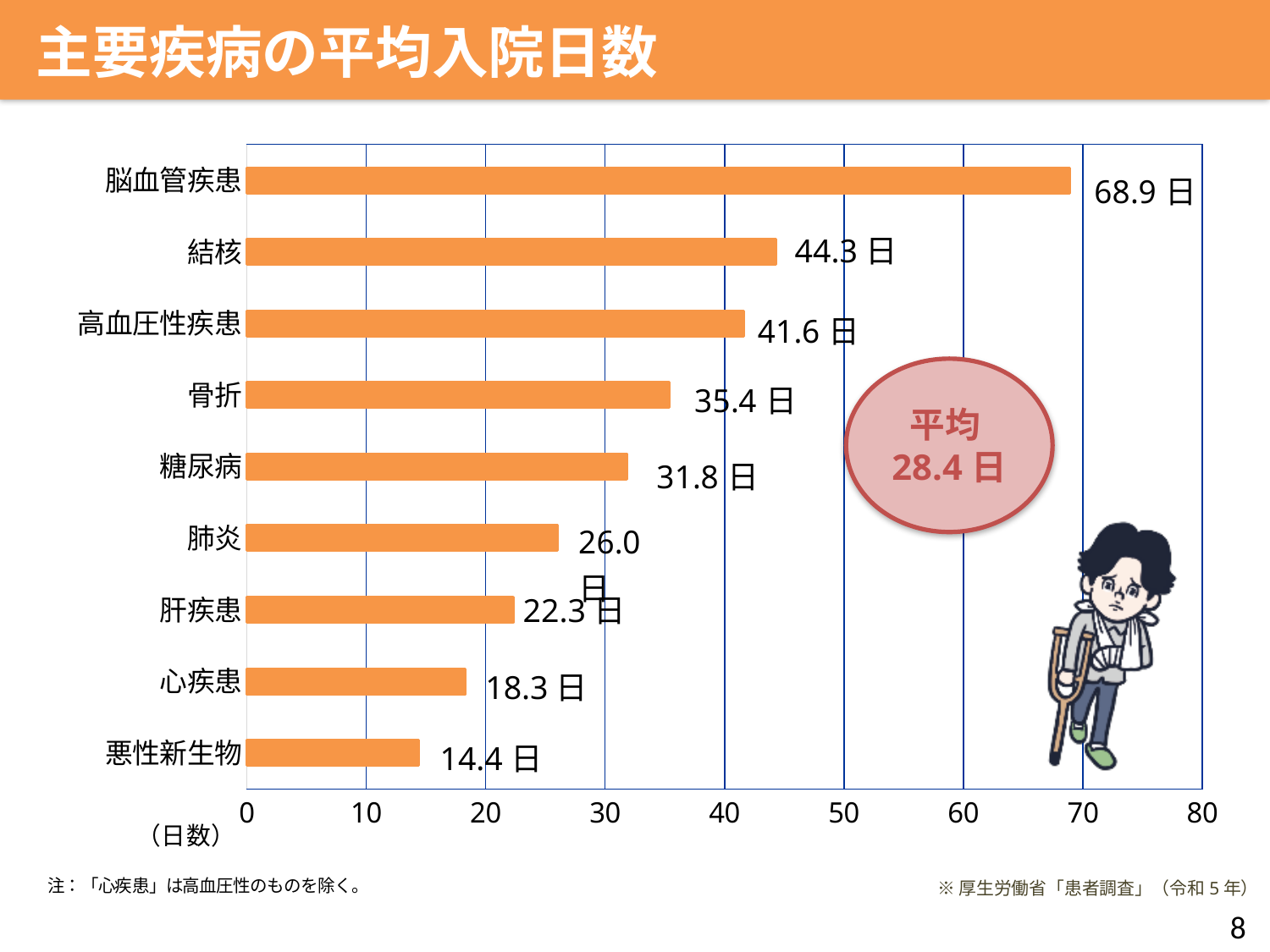
Is the value for 心疾患 greater or less than 20? less Which disease has the shortest average hospital stay? 悪性新生物 What is the average hospital stay for 脳血管疾患? 68.9 日 Which has a longer average hospital stay, 骨折 or 肺炎? 骨折 What kind of chart is shown on the slide? bar chart What is the average hospital stay for 悪性新生物? 14.4 日 How many diseases are shown in the chart? 9 What is the title of the slide? 主要疾病の平均入院日数 What is the difference in average hospital stay between 結核 and 高血圧性疾患? 2.7 日 What is the average hospital stay for 糖尿病? 31.8 日 What is the overall average number of hospital days shown in the circle on the chart? 28.4 日 Which disease has the longest average hospital stay? 脳血管疾患